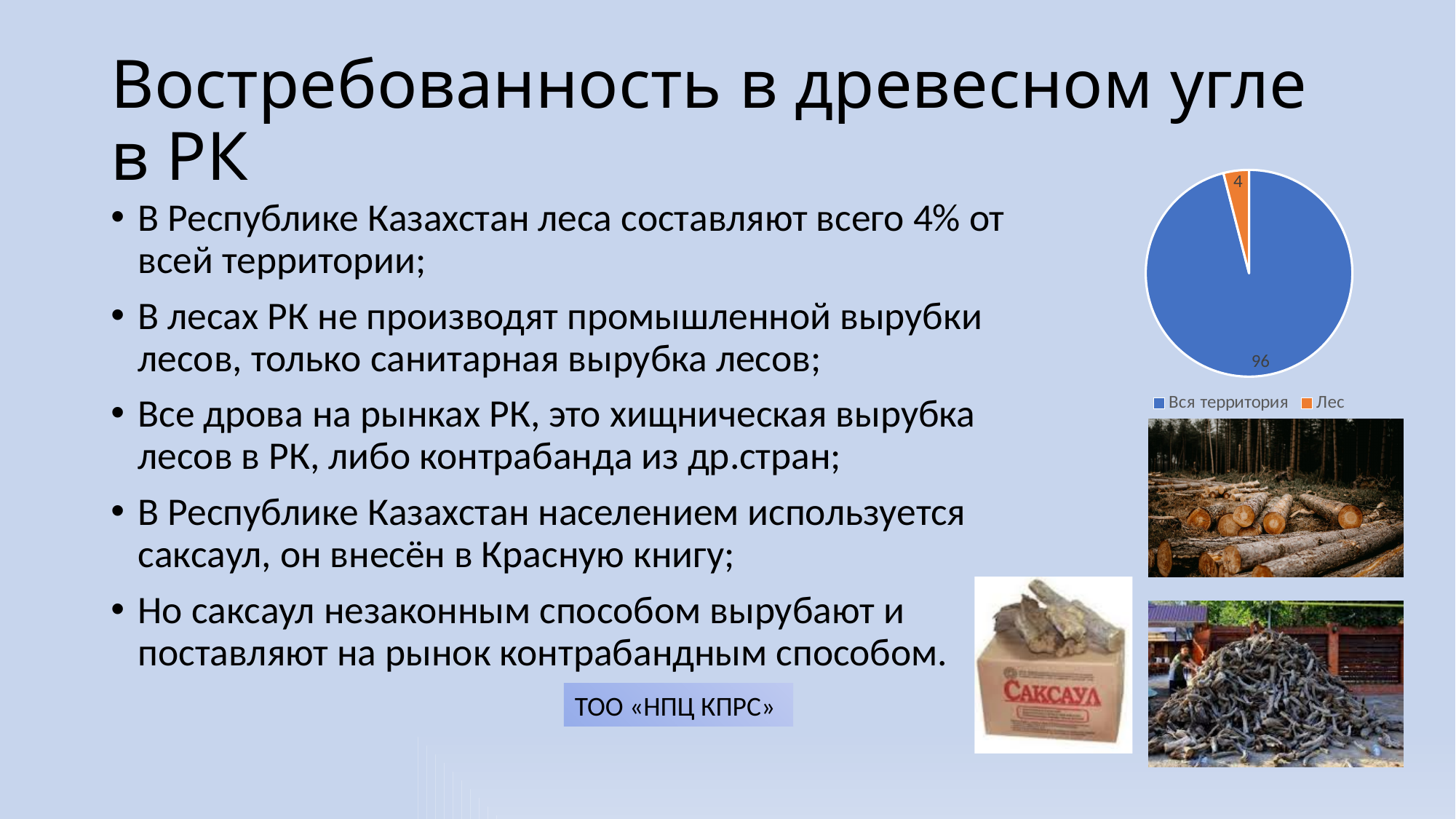
What share of the pie chart does the "Лес" slice represent? 4% What colour is the "Лес" slice in the pie chart? orange What is the value shown for the "Вся территория" slice of the pie chart? 96 How many entries does the legend of the pie chart list? 2 Which slice of the pie chart is the largest? Вся территория What kind of chart is shown on the slide? pie chart What is the difference between the values for "Вся территория" and "Лес" in the pie chart? 92 Which slice of the pie chart is the smallest? Лес What colour is the "Вся территория" slice in the pie chart? blue Which is larger in the pie chart, "Вся территория" or "Лес"? Вся территория How many slices does the pie chart have? 2 What is the value shown for the "Лес" slice of the pie chart? 4